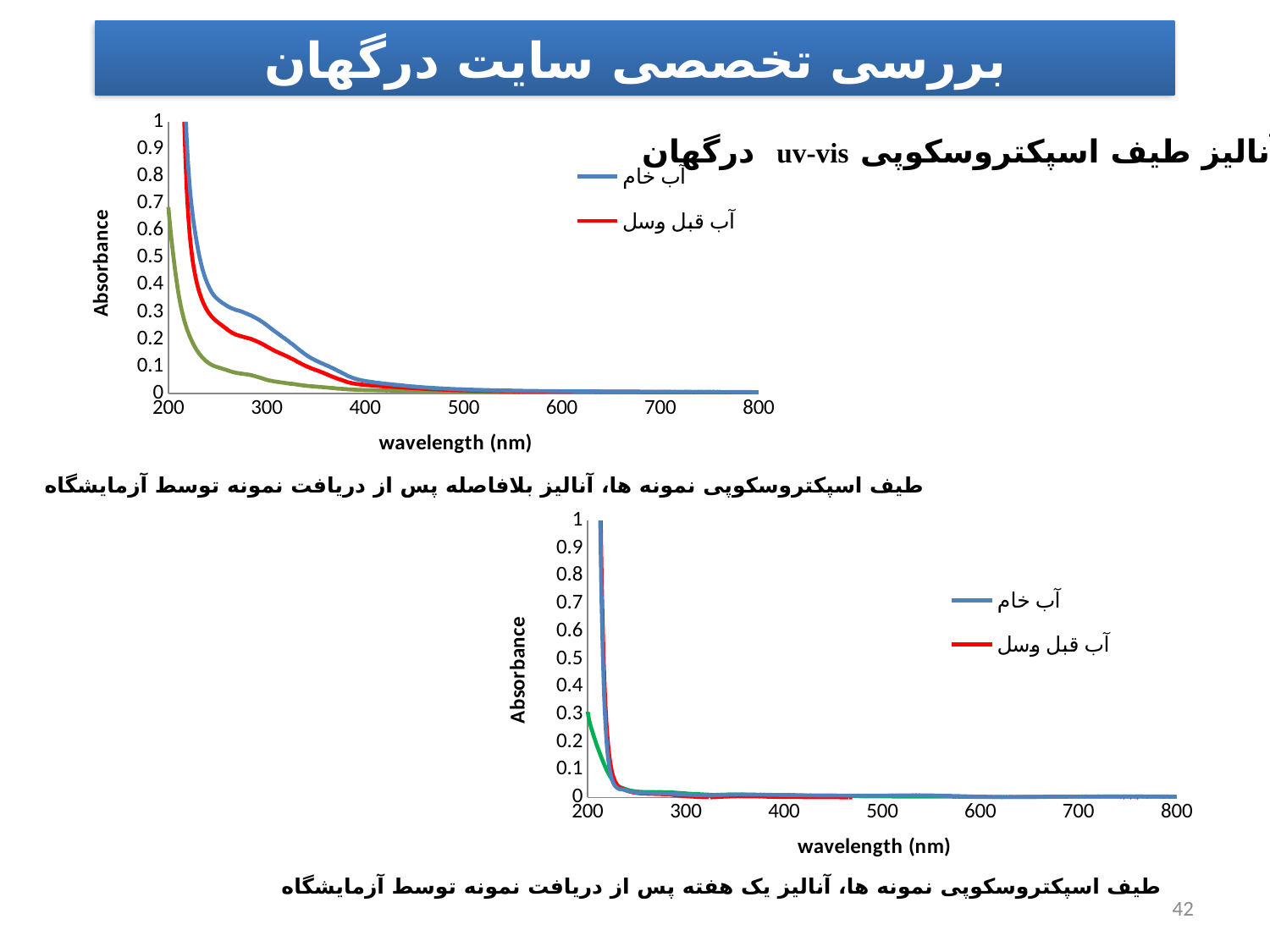
What kind of chart is the top chart on the slide? line chart In the bottom chart, what is the label of the y axis? Absorbance How many series does the legend of the top chart list? 2 In the top chart, is the absorbance of the green line at 300 nm greater or less than 0.1? less In the top chart, is the absorbance of the blue line (آب خام) at 300 nm greater or less than 0.2? greater In the top chart, do the absorbance values rise or fall as wavelength increases from 200 to 800 nm? fall In the bottom chart, is the absorbance of the blue line (آب خام) at 300 nm greater or less than 0.1? less In the top chart, what is the label of the x axis? wavelength (nm) How many series does the legend of the bottom chart list? 2 In the bottom chart, do the absorbance values rise or fall as wavelength increases from 200 to 800 nm? fall In the top chart, at 300 nm, which line has the higher absorbance, the blue line (آب خام) or the red line (آب قبل وسل)? the blue line (آب خام)